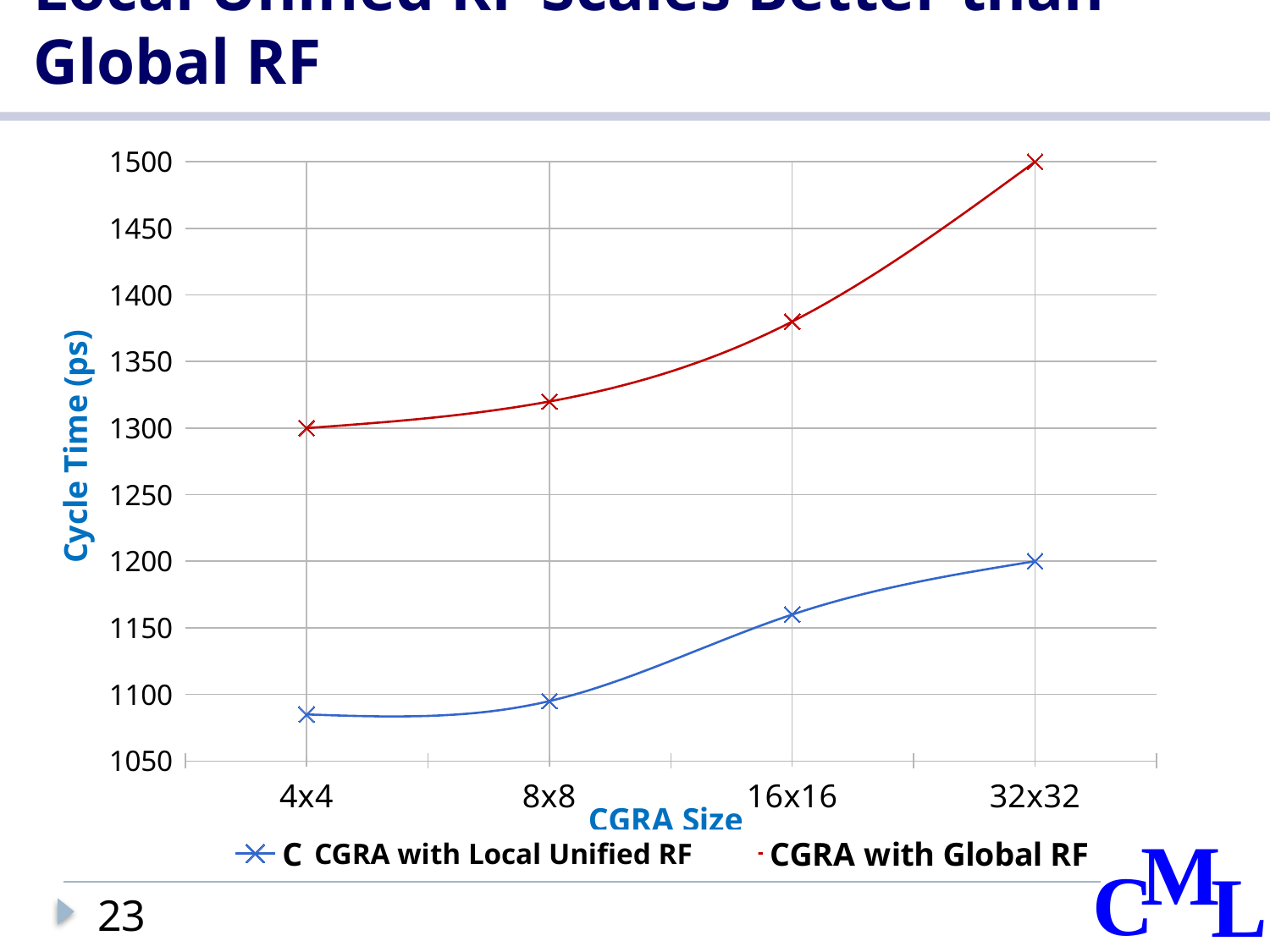
Does the cycle time for CGRA with Global RF rise or fall as CGRA size increases from 4x4 to 32x32? rise What is the label of the y axis? Cycle Time (ps) What kind of chart is shown on the slide? line chart What is the cycle time for CGRA with Global RF at 32x32? 1500 Is the cycle time for CGRA with Local Unified RF at 4x4 greater or less than 1100? less Which series has the higher cycle time at 16x16, CGRA with Local Unified RF or CGRA with Global RF? CGRA with Global RF What is the difference in cycle time between CGRA with Global RF and CGRA with Local Unified RF at 32x32? 300 Is the cycle time for CGRA with Global RF at 16x16 greater or less than 1350? greater What is the cycle time for CGRA with Global RF at 4x4? 1300 What is the cycle time for CGRA with Local Unified RF at 32x32? 1200 How many CGRA sizes are plotted along the x axis? 4 How many series does the legend list? 2